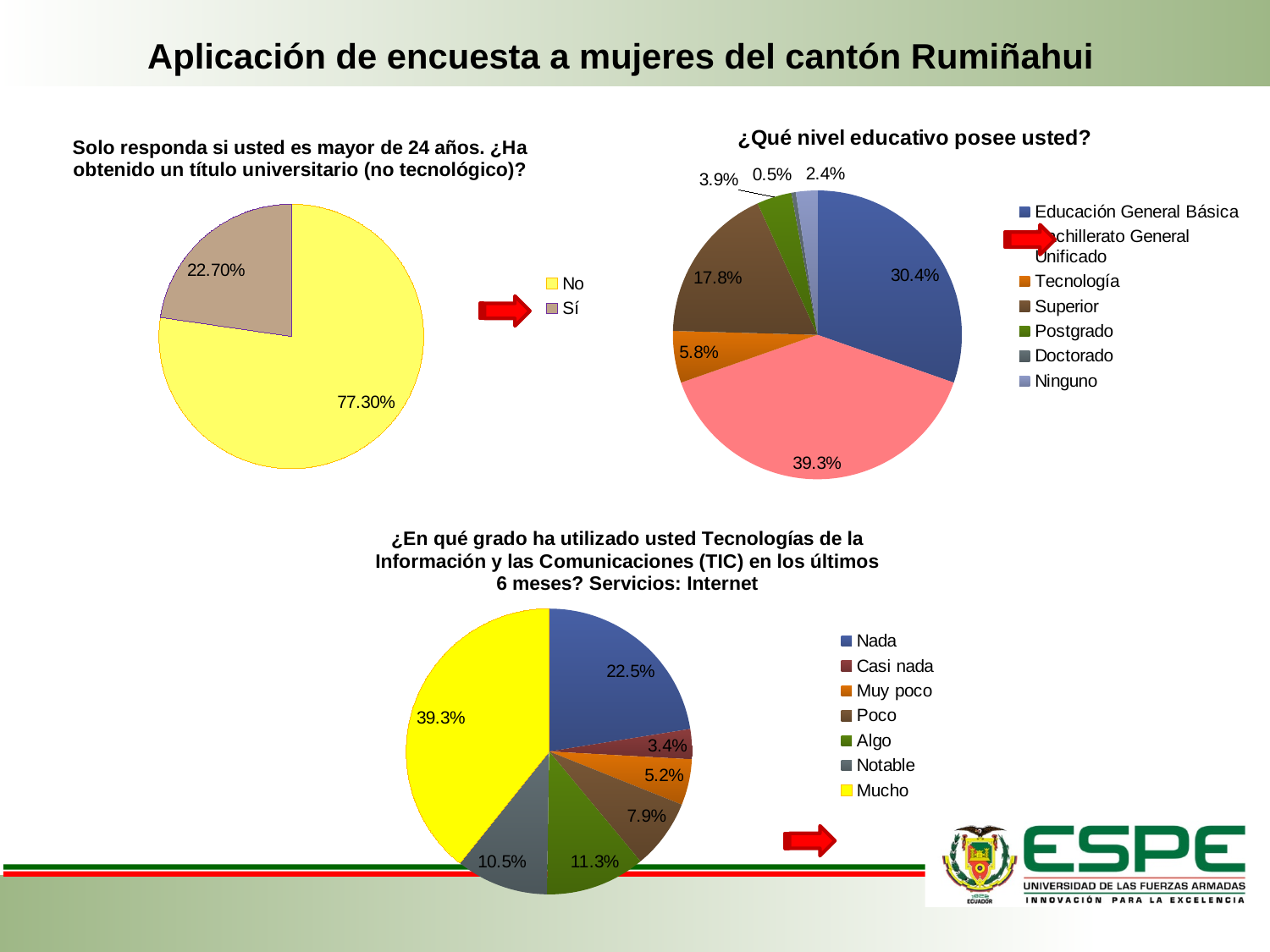
In the chart titled "¿Qué nivel educativo posee usted?", which category has the largest share? Bachillerato General Unificado In the chart titled "Solo responda si usted es mayor de 24 años. ¿Ha obtenido un título universitario (no tecnológico)?", what percentage answered "Sí"? 22.70% In the chart titled "Solo responda si usted es mayor de 24 años. ¿Ha obtenido un título universitario (no tecnológico)?", what type of chart is used? Pie chart In the chart titled "¿Qué nivel educativo posee usted?", what is the value for "Superior"? 17.8% In the chart titled "Solo responda si usted es mayor de 24 años. ¿Ha obtenido un título universitario (no tecnológico)?", what percentage answered "No"? 77.30% In the chart titled "¿En qué grado ha utilizado usted Tecnologías de la Información y las Comunicaciones (TIC) en los últimos 6 meses? Servicios: Internet", which is larger, "Algo" or "Notable"? Algo In the chart titled "¿Qué nivel educativo posee usted?", which category has the smallest share? Doctorado In the chart titled "¿En qué grado ha utilizado usted Tecnologías de la Información y las Comunicaciones (TIC) en los últimos 6 meses? Servicios: Internet", what colour is the "Mucho" slice? Yellow In the chart titled "¿Qué nivel educativo posee usted?", what is the difference between "Educación General Básica" and "Tecnología"? 24.6% In the chart titled "¿En qué grado ha utilizado usted Tecnologías de la Información y las Comunicaciones (TIC) en los últimos 6 meses? Servicios: Internet", what is the value for "Mucho"? 39.3% In the chart titled "¿En qué grado ha utilizado usted Tecnologías de la Información y las Comunicaciones (TIC) en los últimos 6 meses? Servicios: Internet", which category has the smallest share? Casi nada In the chart titled "¿Qué nivel educativo posee usted?", how many categories does the legend list? 7